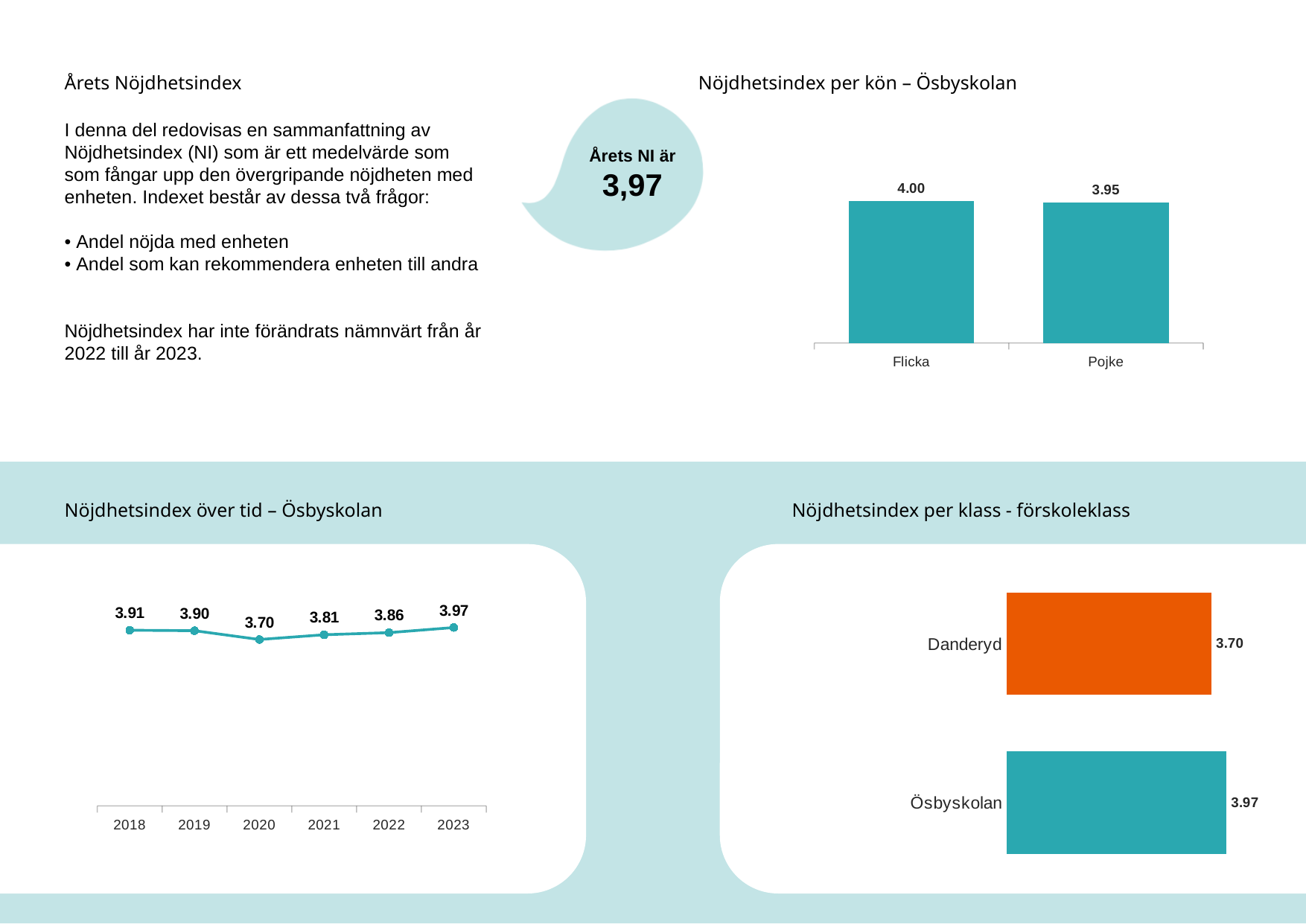
In the chart 'Nöjdhetsindex över tid – Ösbyskolan', what is the value for 2020? 3.70 What kind of chart is 'Nöjdhetsindex per kön – Ösbyskolan'? Bar chart In the chart 'Nöjdhetsindex per kön – Ösbyskolan', what is the difference between the values for Flicka and Pojke? 0.05 In the chart 'Nöjdhetsindex per klass - förskoleklass', what is the value for Danderyd? 3.70 In the chart 'Nöjdhetsindex över tid – Ösbyskolan', what is the difference between the values for 2023 and 2022? 0.11 In the chart 'Nöjdhetsindex per kön – Ösbyskolan', what is the value for Pojke? 3.95 In the chart 'Nöjdhetsindex över tid – Ösbyskolan', how many years are plotted? 6 In the chart 'Nöjdhetsindex över tid – Ösbyskolan', which year has the lowest value? 2020 In the chart 'Nöjdhetsindex per klass - förskoleklass', which category has the higher value, Danderyd or Ösbyskolan? Ösbyskolan In the chart 'Nöjdhetsindex över tid – Ösbyskolan', which year has the highest value? 2023 In the chart 'Nöjdhetsindex per kön – Ösbyskolan', what is the value for Flicka? 4.00 What kind of chart is 'Nöjdhetsindex över tid – Ösbyskolan'? Line chart